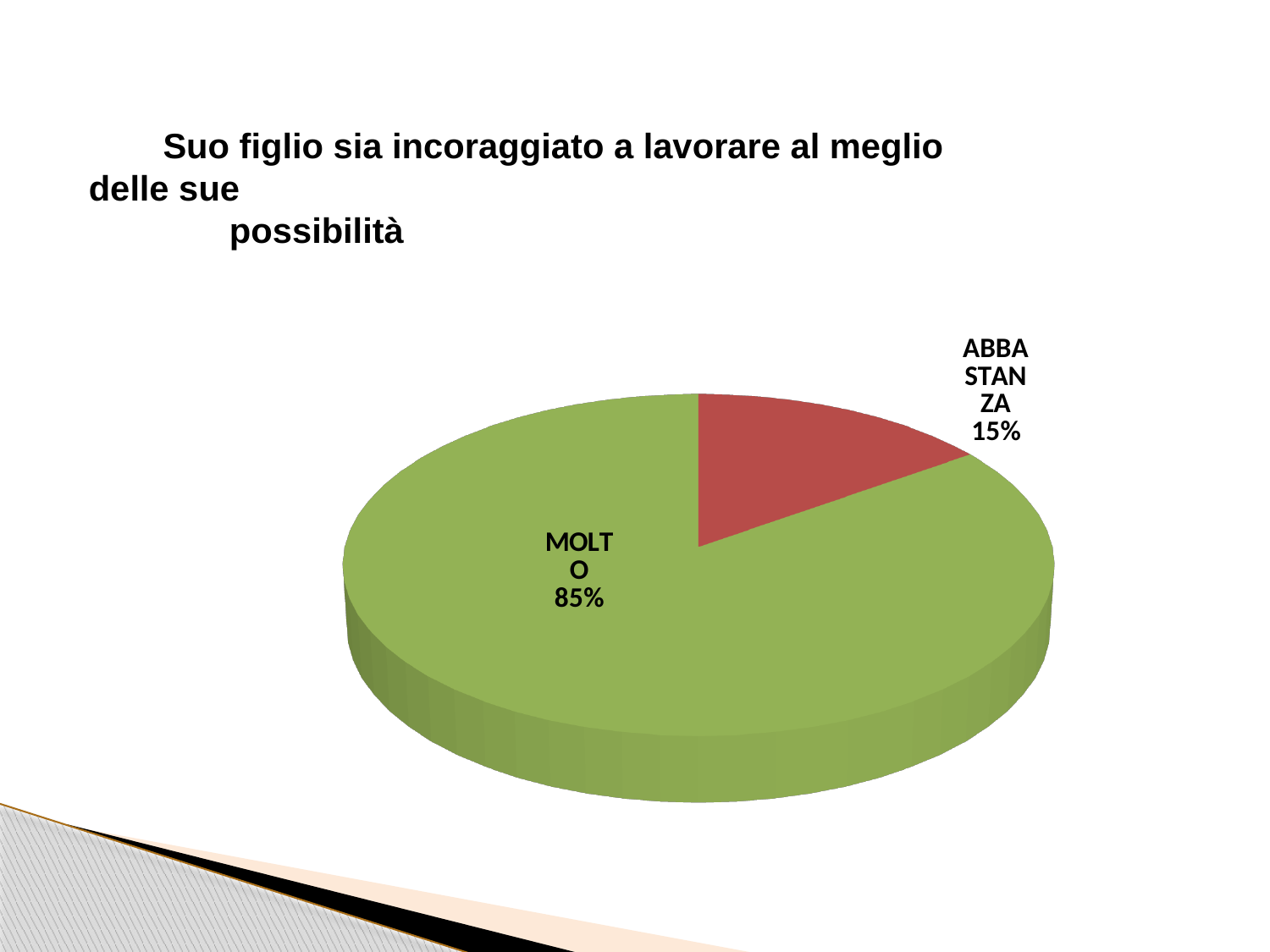
What colour is the MOLTO slice? green Which category has the smallest slice of the pie? ABBASTANZA What is the total of the two slice percentages shown? 100% What is the difference in percentage points between the MOLTO and ABBASTANZA slices? 70 What kind of chart is shown on the slide? pie chart What colour is the ABBASTANZA slice? red How many slices does the pie chart have? 2 What share of the pie does ABBASTANZA represent? 15% Which category has the largest slice of the pie? MOLTO Which is larger, the MOLTO slice or the ABBASTANZA slice? MOLTO What share of the pie does MOLTO represent? 85%